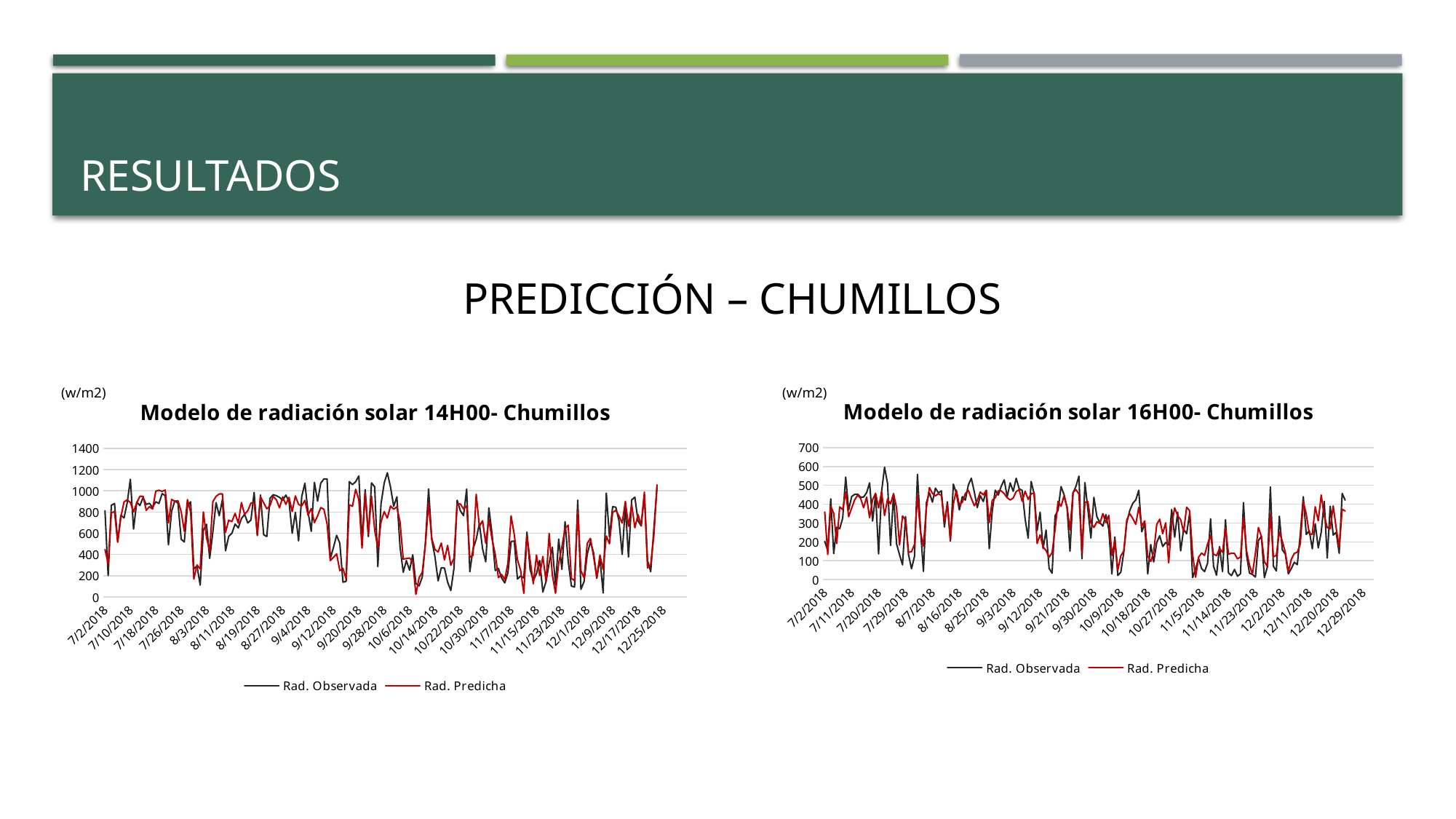
What is the highest value shown on the y axis of the 'Modelo de radiación solar 16H00- Chumillos' chart? 700 In the 'Modelo de radiación solar 14H00- Chumillos' chart, is the Rad. Observada value around 7/10/2018 greater or less than 600? greater What is the first date shown on the x axis of the 'Modelo de radiación solar 14H00- Chumillos' chart? 7/2/2018 How many series does the legend of the 'Modelo de radiación solar 16H00- Chumillos' chart list? 2 In the 'Modelo de radiación solar 16H00- Chumillos' chart, does any value reach 700? No In the 'Modelo de radiación solar 16H00- Chumillos' chart, is the Rad. Observada value around 11/5/2018 greater or less than 300? less What is the last date shown on the x axis of the 'Modelo de radiación solar 16H00- Chumillos' chart? 12/29/2018 In the 'Modelo de radiación solar 14H00- Chumillos' chart, what are the two series named in the legend? Rad. Observada and Rad. Predicha What is the highest value shown on the y axis of the 'Modelo de radiación solar 14H00- Chumillos' chart? 1400 What kind of chart is the 'Modelo de radiación solar 14H00- Chumillos' chart? line chart In the 'Modelo de radiación solar 16H00- Chumillos' chart, which colour is the Rad. Predicha line? red In the 'Modelo de radiación solar 14H00- Chumillos' chart, are the values in November generally higher or lower than the values in July? lower